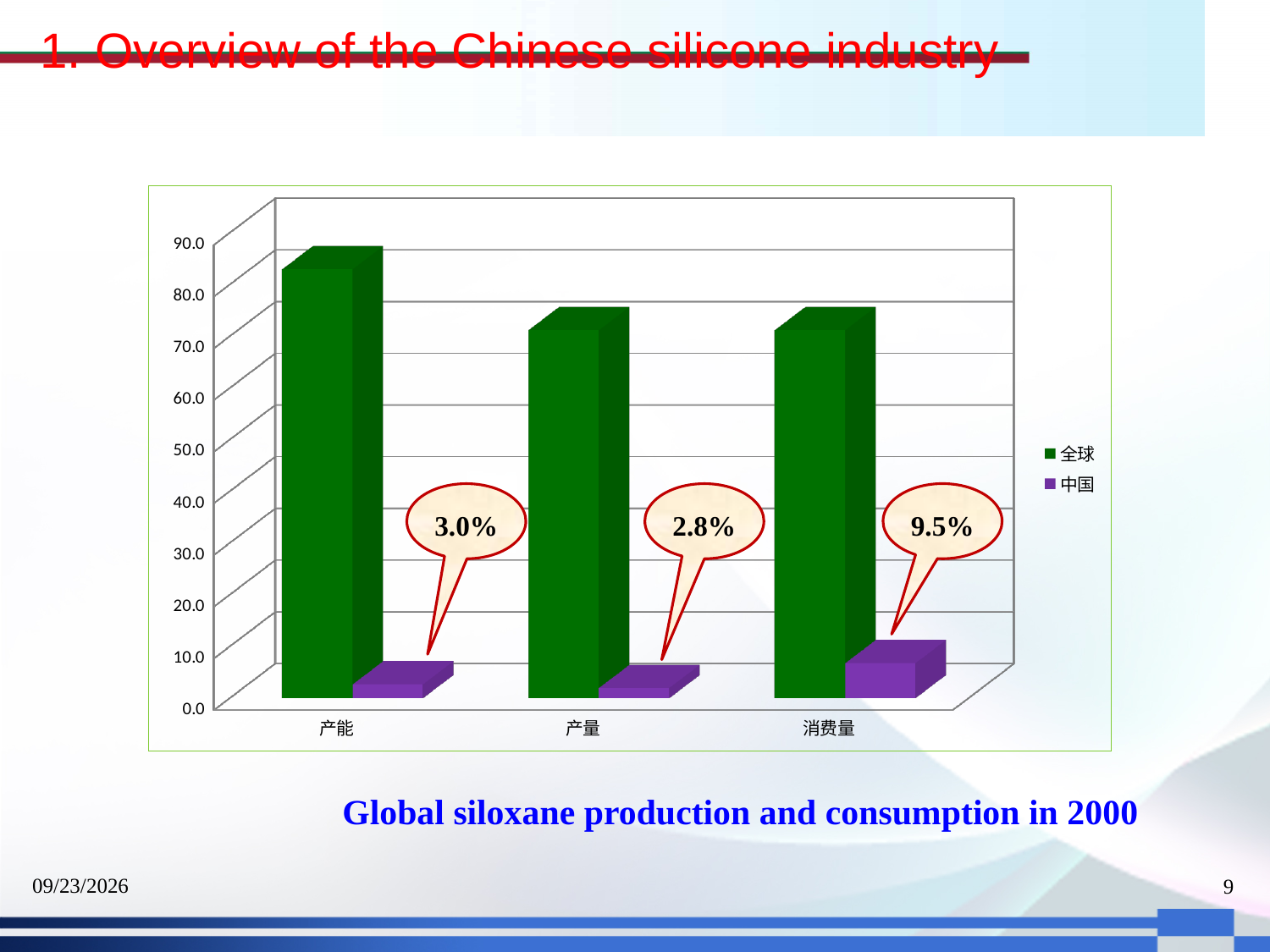
Which is larger, the 全球 value for 产能 or the 全球 value for 消费量? 产能 Which is larger, the 中国 value for 产量 or the 中国 value for 消费量? 消费量 What percentage is shown in the callout for the 消费量 category? 9.5% What is the caption printed below the chart? Global siloxane production and consumption in 2000 How many categories are shown on the x axis? 3 Is the 中国 value for 消费量 greater or less than 10? less Which category has the highest value for the 全球 series? 产能 How many series does the legend list? 2 What kind of chart is shown on the slide? bar chart Which category has the highest value for the 中国 series? 消费量 Is the 全球 value for 产量 greater or less than 80? less Is the 全球 value for 产能 greater or less than 80? greater